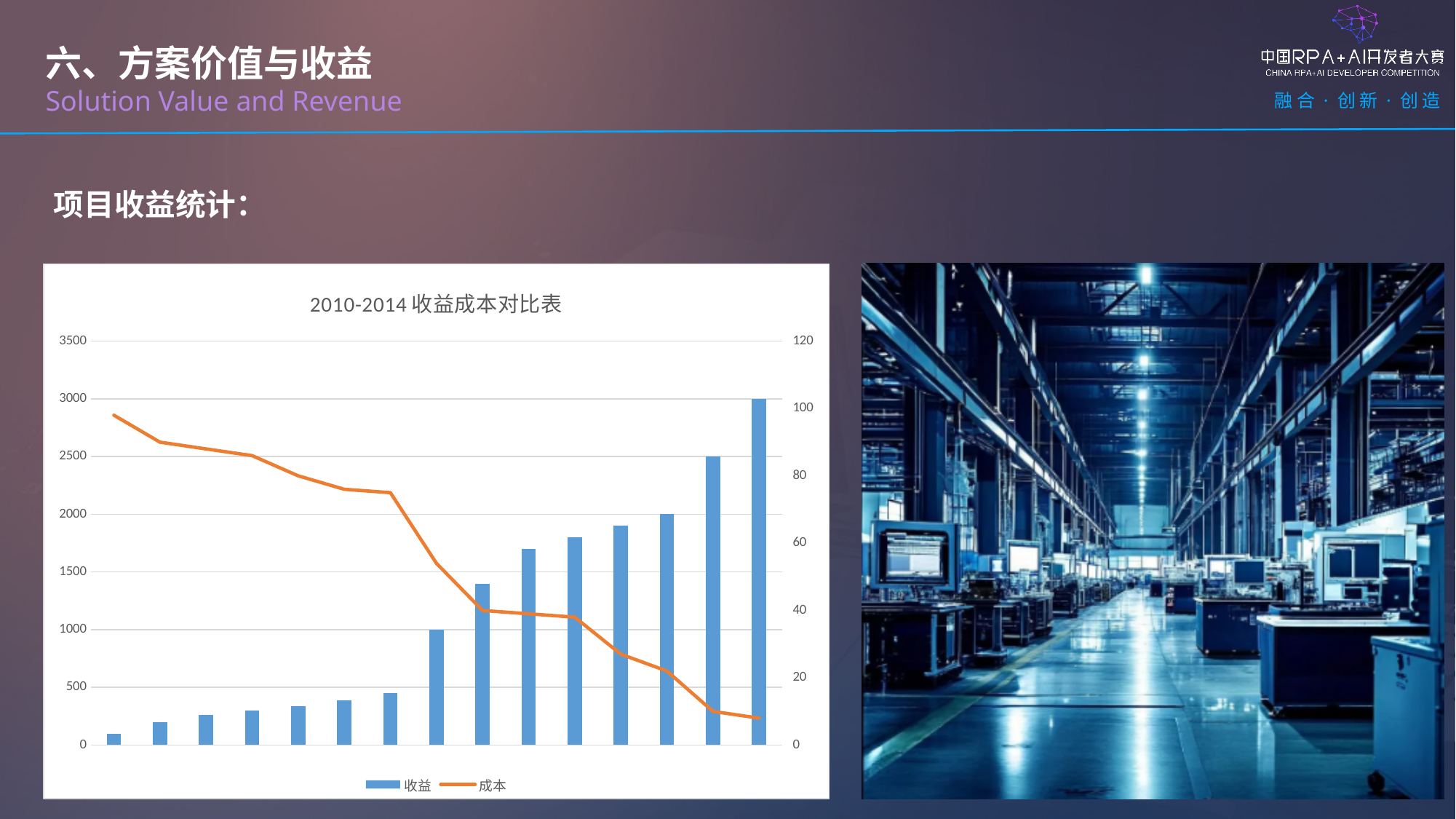
Do the 收益 bars rise or fall from left to right? Rise How many bars are plotted for the 收益 series? 15 How many series does the legend list? 2 What is the title of the chart? 2010-2014 收益成本对比表 Is the value of the last 收益 bar greater or less than 2500? greater Does the 成本 line rise or fall from left to right? Fall On the right axis, is the first point of the 成本 line greater or less than 80? greater Which series is drawn as a line? 成本 Is the value of the first 收益 bar greater or less than 500? less Which bar is the highest in the 收益 series? The last (rightmost) bar Which bar is the lowest in the 收益 series? The first (leftmost) bar What kind of chart is shown on the slide? A combined bar and line chart